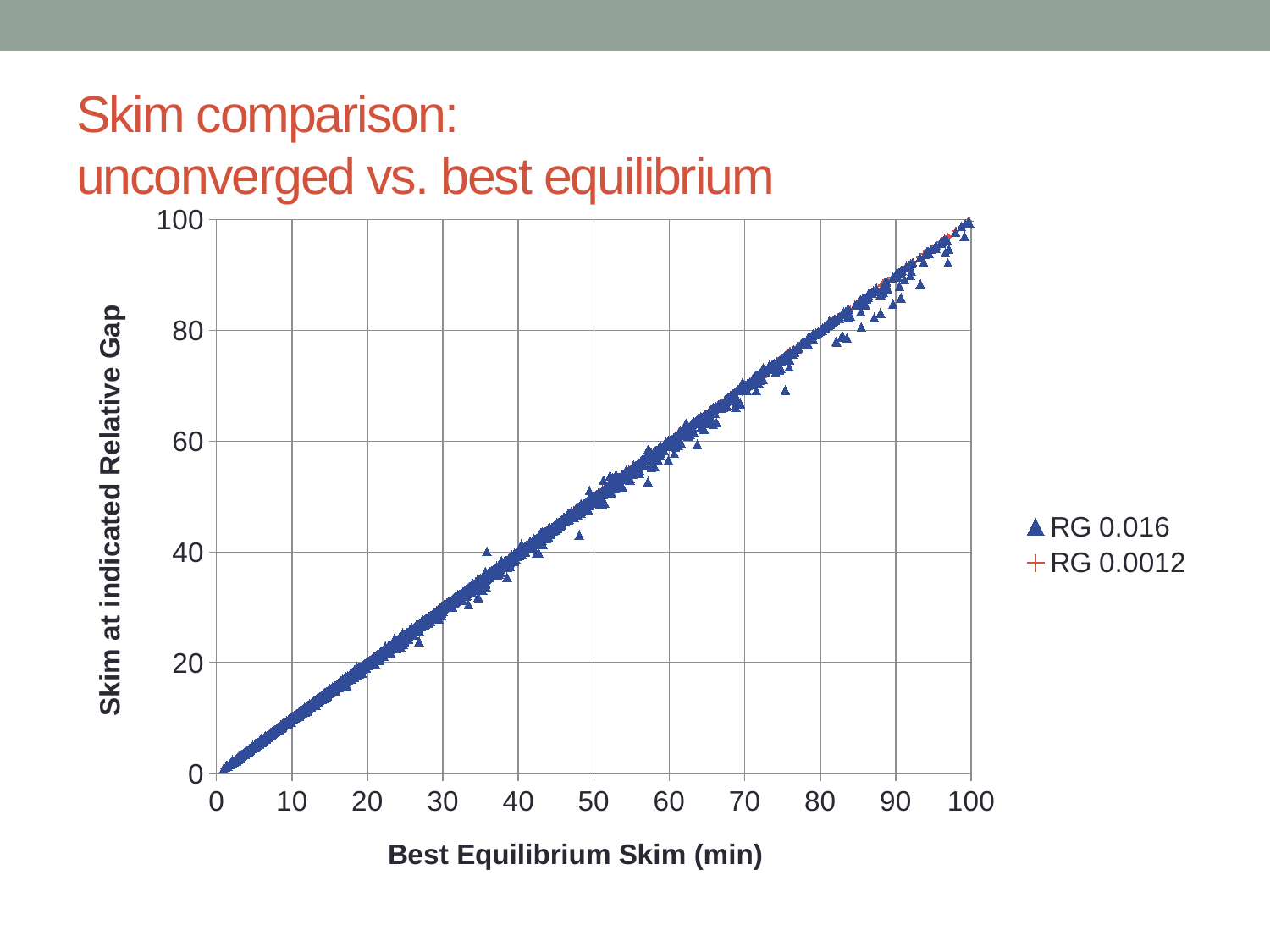
What is the maximum value shown on the y axis? 100 What is the maximum value shown on the x axis? 100 Which series is plotted with triangle markers? RG 0.016 What kind of chart is shown on the slide? scatter plot For points near a Best Equilibrium Skim of 100, is the y value greater or less than 80? greater What is the label of the x axis? Best Equilibrium Skim (min) What is the title of the chart on the slide? Skim comparison: unconverged vs. best equilibrium For points near a Best Equilibrium Skim of 20, is the y value greater or less than 40? less What are the two series named in the legend? RG 0.016 and RG 0.0012 Do the plotted values rise or fall as the x axis increases? rise How many series does the legend list? 2 What is the label of the y axis? Skim at indicated Relative Gap